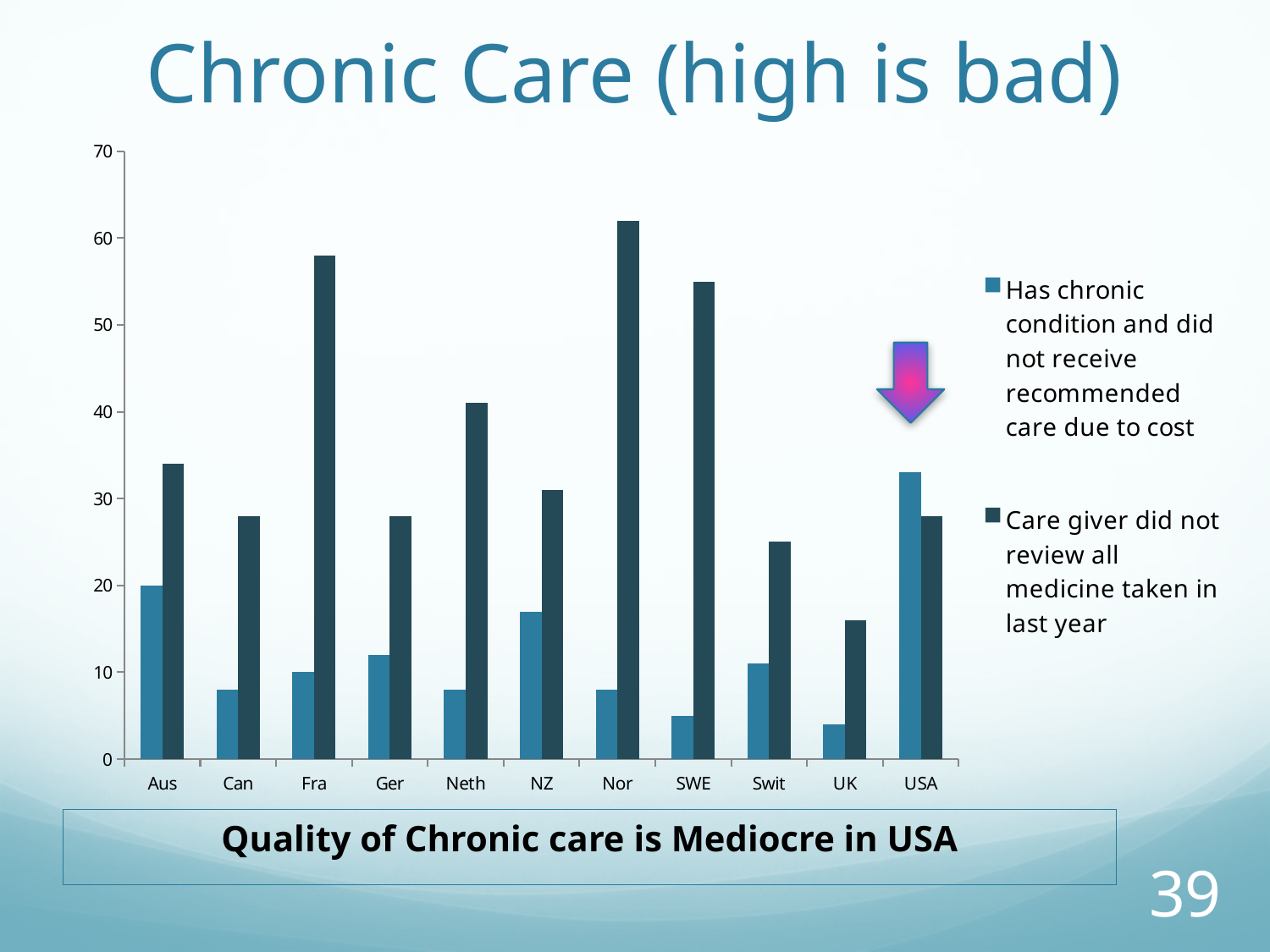
What kind of chart is shown on the slide? bar chart How many series does the legend list? 2 Is the value for Fra in the 'Care giver did not review all medicine taken in last year' series greater or less than 50? greater For 'Care giver did not review all medicine taken in last year', which is larger: Nor or SWE? Nor Is the value for USA in the 'Has chronic condition and did not receive recommended care due to cost' series greater or less than 30? greater How many countries are shown on the x axis? 11 Which country has the lowest value for 'Care giver did not review all medicine taken in last year'? UK What is the value for Aus in the 'Has chronic condition and did not receive recommended care due to cost' series? 20 Which country has the highest value for 'Has chronic condition and did not receive recommended care due to cost'? USA Which country has the highest value for 'Care giver did not review all medicine taken in last year'? Nor Which country has the lowest value for 'Has chronic condition and did not receive recommended care due to cost'? UK What is the title of the slide containing the chart? Chronic Care (high is bad)